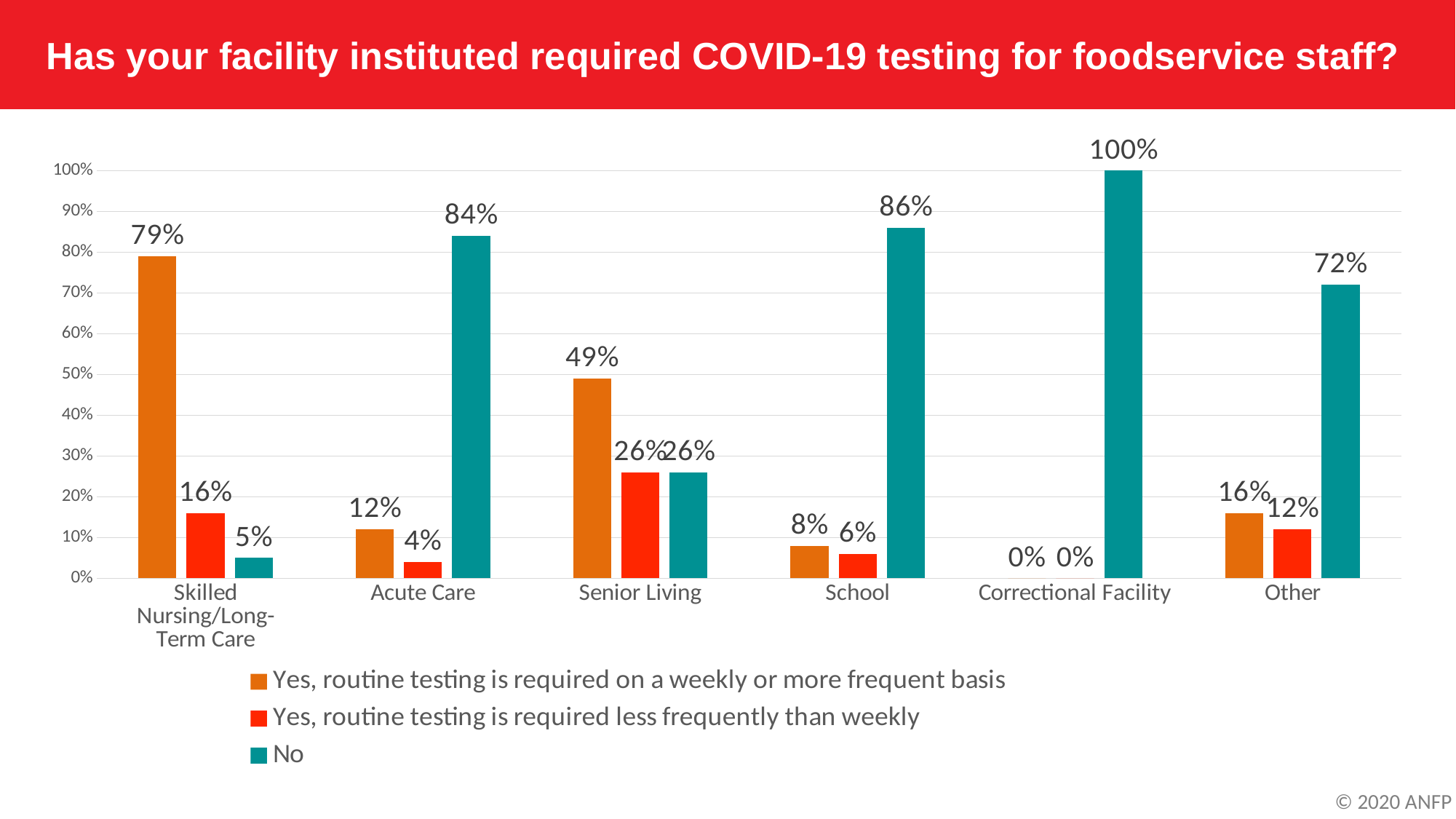
How many facility types are shown on the x axis? 6 What colour represents the "No" series? Teal What is the total of the three values for Acute Care? 100% What kind of chart is shown on the slide? Bar chart What percentage of Correctional Facility respondents answered "No"? 100% What is the difference between the "No" values for School and Other? 14% How many series does the legend list? 3 Which facility type has the lowest value in the "No" series? Skilled Nursing/Long-Term Care What percentage of Skilled Nursing/Long-Term Care facilities answered "No"? 5% Which facility type has the highest value for "Yes, routine testing is required on a weekly or more frequent basis"? Skilled Nursing/Long-Term Care Which is larger: the "Yes, routine testing is required less frequently than weekly" value for Acute Care or for Other? Other What is the value for Senior Living in the "Yes, routine testing is required on a weekly or more frequent basis" series? 49%